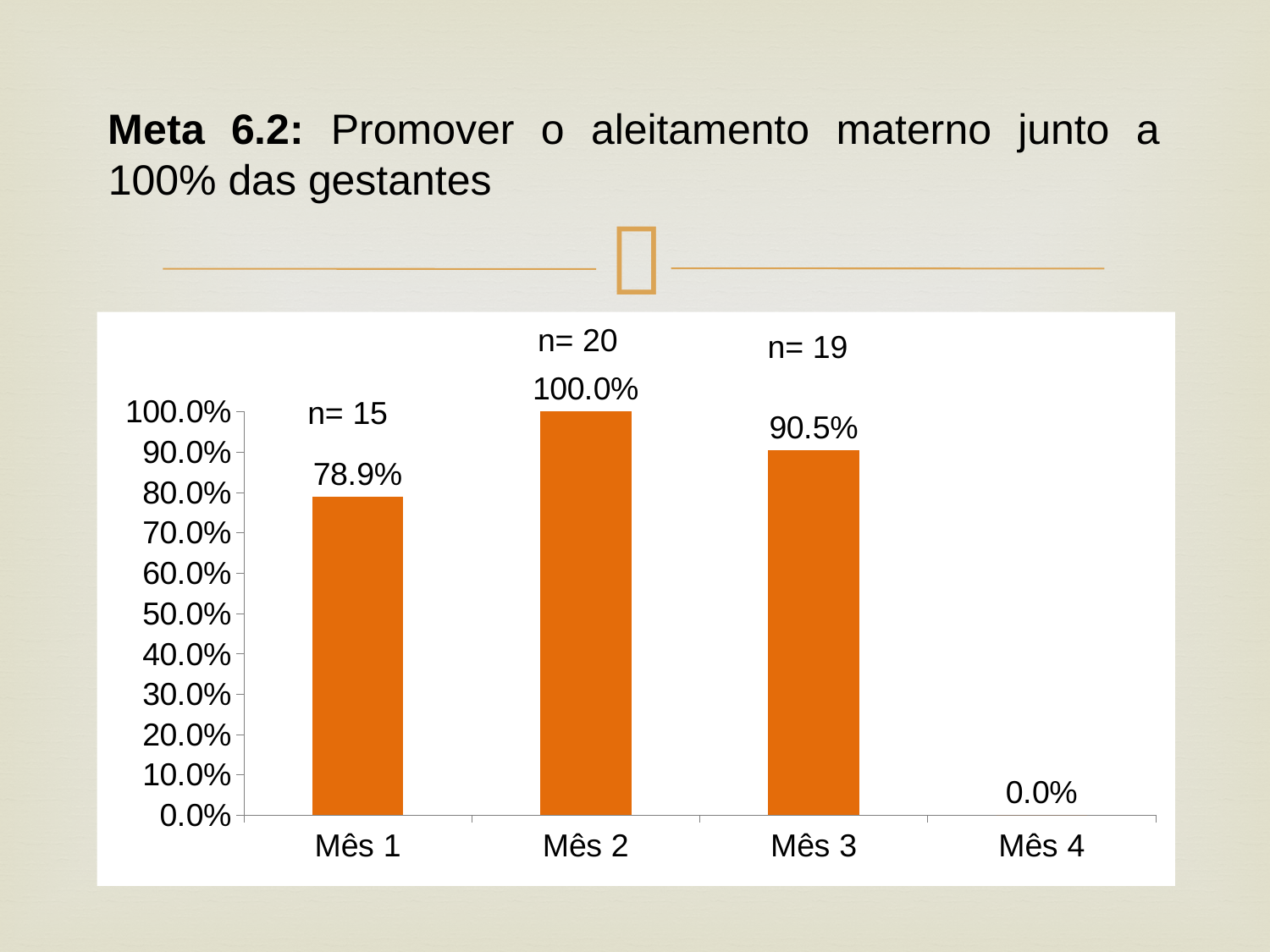
What kind of chart is shown on the slide? Bar chart What is the n value annotated above the bar for Mês 2? n= 20 Which month has the highest value? Mês 2 What is the difference between the values for Mês 3 and Mês 1? 11.6% What is the value for Mês 3? 90.5% What is the value for Mês 1? 78.9% What is the value for Mês 2? 100.0% What is the value for Mês 4? 0.0% How many months are shown on the x axis? 4 Which is larger, the value for Mês 1 or the value for Mês 3? Mês 3 What is the difference between the values for Mês 2 and Mês 1? 21.1% Which month has the lowest value? Mês 4